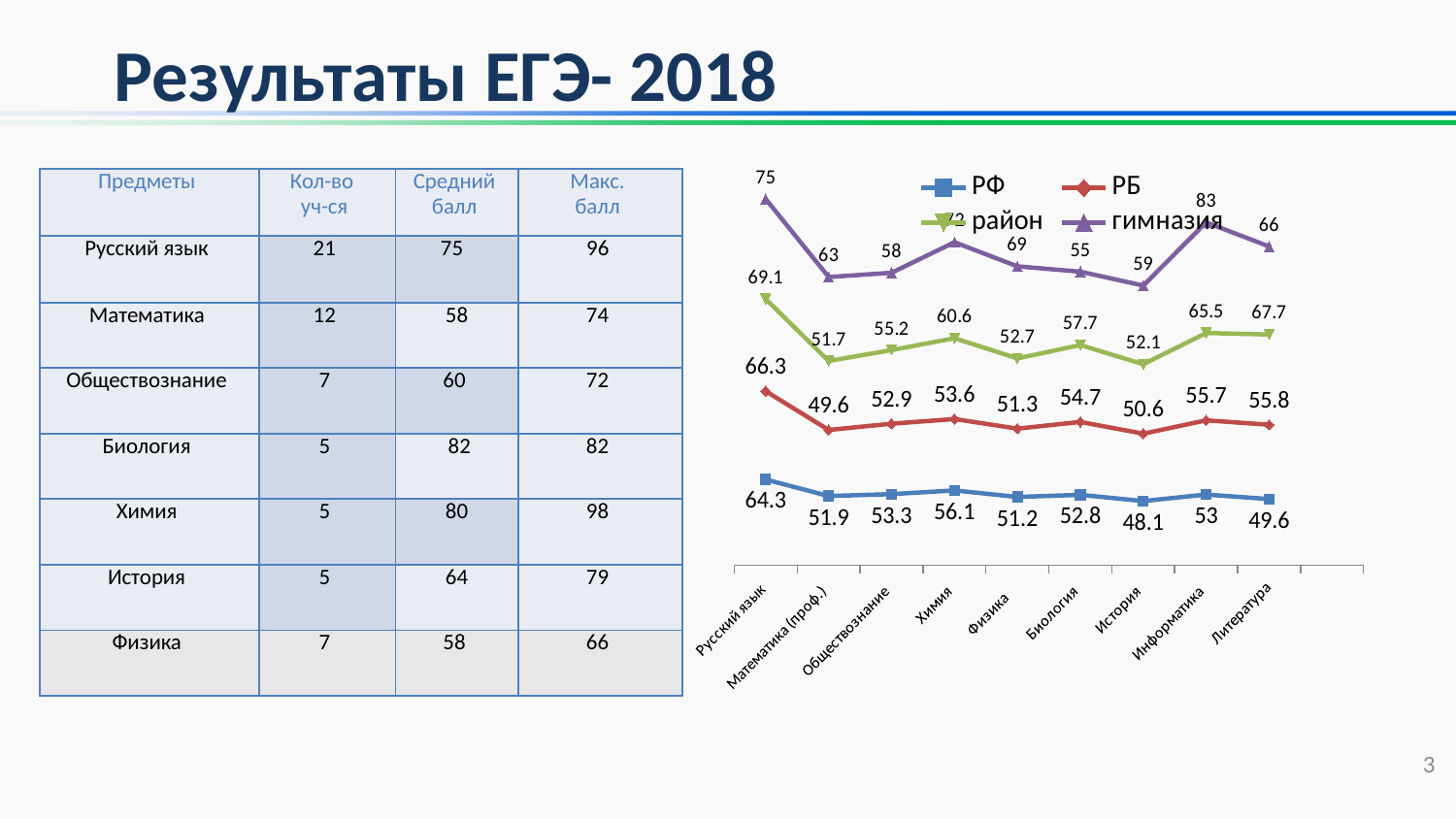
How many subjects are plotted along the x axis of the line chart? 9 In the line chart, what is the value of the район series for Литература? 67.7 In the line chart, for which subject is the РФ series lowest? История Which series in the line chart is drawn in red? РБ In the line chart, what is the difference between the гимназия and РФ values for Русский язык? 10.7 In the line chart, which is larger for Литература: the район value or the РБ value? район In the line chart, what is the value of the РБ series for Биология? 54.7 How many series does the legend of the line chart list? 4 In the line chart, what is the value of the гимназия series for Информатика? 83 In the line chart, for which subject is the гимназия series highest? Информатика What kind of chart is shown on the right of the slide? line chart In the line chart, what is the value of the РФ series for Русский язык? 64.3